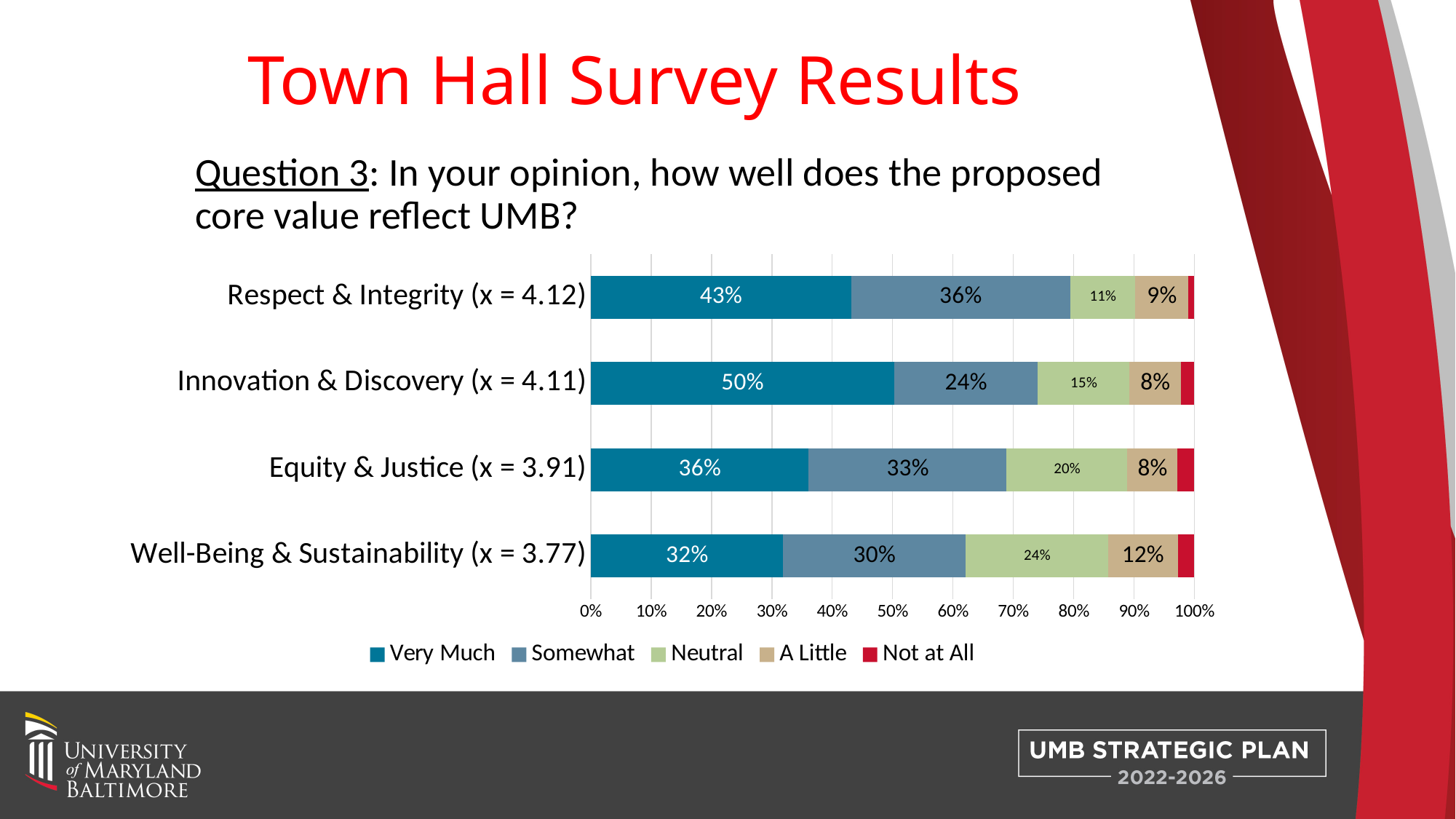
Which legend entry is shown in red? Not at All What kind of chart is shown on the slide? Stacked bar chart What is the difference between the "Very Much" percentages for Innovation & Discovery and Well-Being & Sustainability? 18% What is the "Very Much" percentage for Innovation & Discovery? 50% How many core values (categories) are plotted in the chart? 4 What is the "Somewhat" percentage for Equity & Justice? 33% What is the "Neutral" percentage for Well-Being & Sustainability? 24% Which core value has the lowest "Very Much" percentage? Well-Being & Sustainability What is the "A Little" percentage for Respect & Integrity? 9% Which is larger: the "Somewhat" percentage for Respect & Integrity or for Innovation & Discovery? Respect & Integrity Which core value has the highest "Very Much" percentage? Innovation & Discovery How many series does the legend list? 5